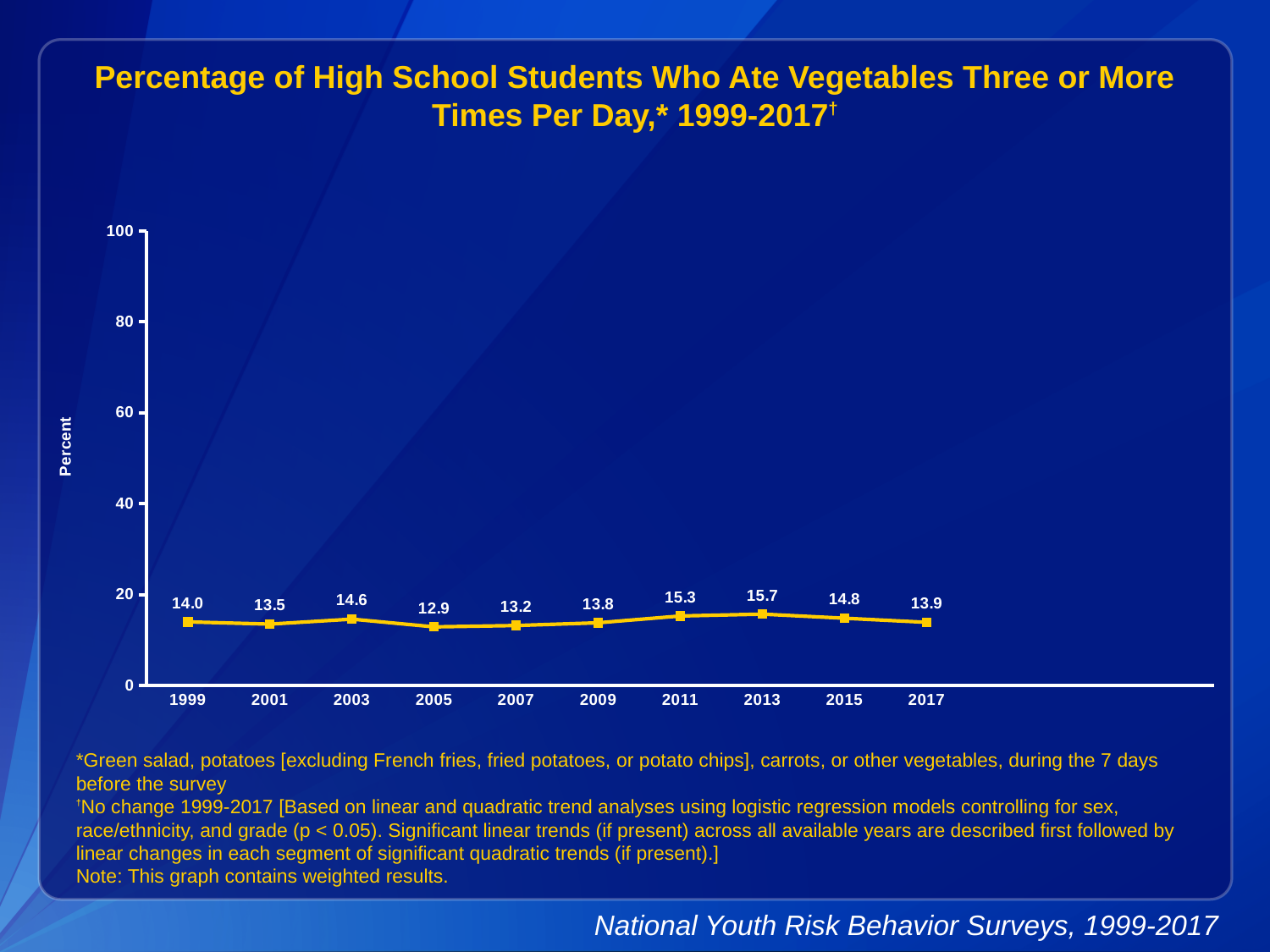
What is the value plotted for 2013? 15.7 Which year has the lowest value on the chart? 2005 What is the label on the y axis? Percent Did the value rise or fall from 2015 to 2017? fall What is the value plotted for 2017? 13.9 Which year has the larger value, 2011 or 2007? 2011 What kind of chart is shown on the slide? line chart What is the difference between the values for 2013 and 2005? 2.8 Which year has the highest value on the chart? 2013 How many years are plotted on the x axis? 10 Is the value for 2003 greater or less than 20? less What percentage of high school students ate vegetables three or more times per day in 1999? 14.0